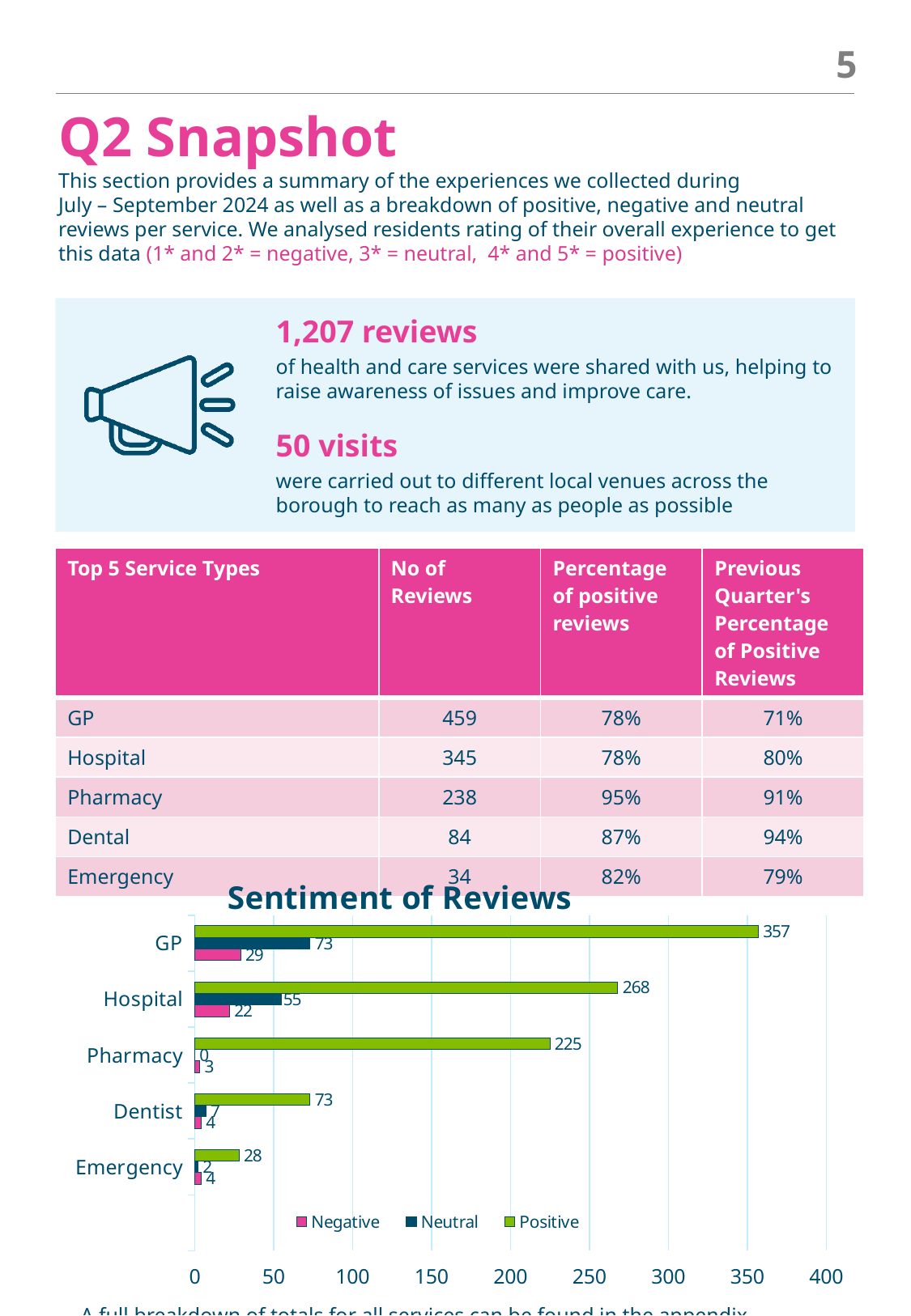
In the 'Sentiment of Reviews' chart, what is the Negative value for Pharmacy? 3 In the 'Sentiment of Reviews' chart, what is the difference between the Positive values for GP and Hospital? 89 In the 'Sentiment of Reviews' chart, which is larger: the Neutral value for GP or the Neutral value for Hospital? GP In the 'Sentiment of Reviews' chart, what is the Positive value for GP? 357 How many series does the legend of the 'Sentiment of Reviews' chart list? 3 In the 'Sentiment of Reviews' chart, which service has the lowest Positive value? Emergency In the 'Sentiment of Reviews' chart, which service has the highest Positive value? GP How many service categories are shown on the 'Sentiment of Reviews' chart? 5 In the 'Sentiment of Reviews' chart, which series is shown in green? Positive What type of chart is the 'Sentiment of Reviews' chart? bar chart In the 'Sentiment of Reviews' chart, what is the total of the Negative, Neutral and Positive values for Dentist? 84 In the 'Sentiment of Reviews' chart, what is the Neutral value for Hospital? 55